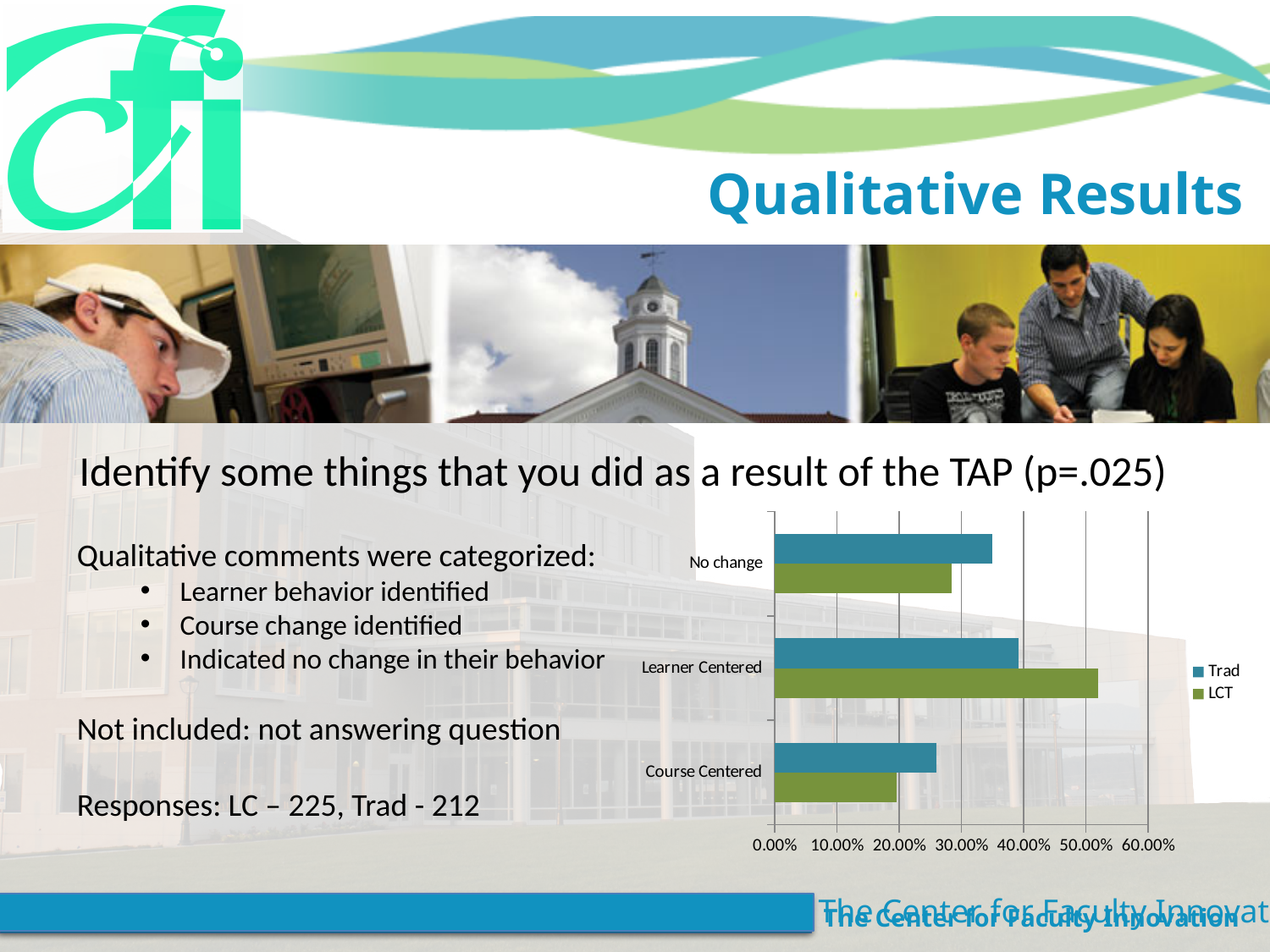
How many categories are shown on the chart's vertical axis? 3 Is the LCT value for Course Centered greater or less than 30.00%? less For Learner Centered, which series has the larger value, Trad or LCT? LCT What are the two series named in the chart's legend? Trad and LCT For No change, which series has the larger value, Trad or LCT? Trad What kind of chart is shown on the slide? bar chart What is the highest value shown on the chart's horizontal axis? 60.00% Which category has the lowest Trad value? Course Centered Which category has the highest LCT value? Learner Centered Which category has the lowest LCT value? Course Centered Is the LCT value for Learner Centered greater or less than 40.00%? greater How many series does the chart's legend list? 2